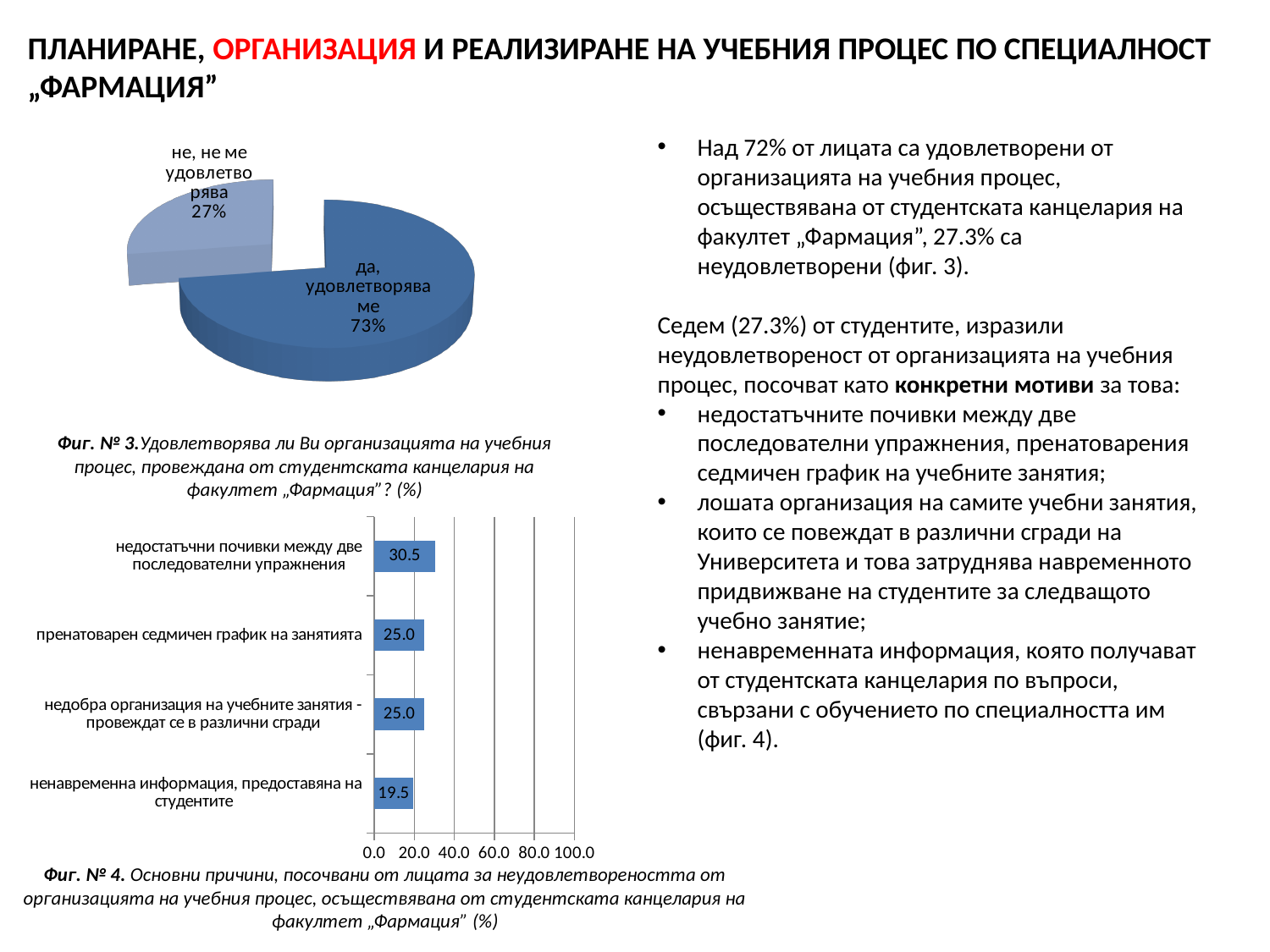
In the bar chart (Фиг. № 4), what is the difference between the values for "недостатъчни почивки между две последователни упражнения" and "ненавременна информация, предоставяна на студентите"? 11.0 In the pie chart (Фиг. № 3), which slice is the largest? да, удовлетворява ме In the bar chart (Фиг. № 4), what is the value for "пренатоварен седмичен график на занятията"? 25.0 In the bar chart (Фиг. № 4), what is the value for "ненавременна информация, предоставяна на студентите"? 19.5 In the bar chart (Фиг. № 4), what is the value for "недостатъчни почивки между две последователни упражнения"? 30.5 How many categories does the bar chart (Фиг. № 4) show? 4 In the bar chart (Фиг. № 4), which category has the highest value? недостатъчни почивки между две последователни упражнения In the pie chart (Фиг. № 3), what share is labelled for "да, удовлетворява ме"? 73% In the pie chart (Фиг. № 3), what share is labelled for "не, не ме удовлетворява"? 27% In the bar chart (Фиг. № 4), which category has the lowest value? ненавременна информация, предоставяна на студентите What kind of chart is Фиг. № 3? pie chart How many slices does the pie chart (Фиг. № 3) have? 2